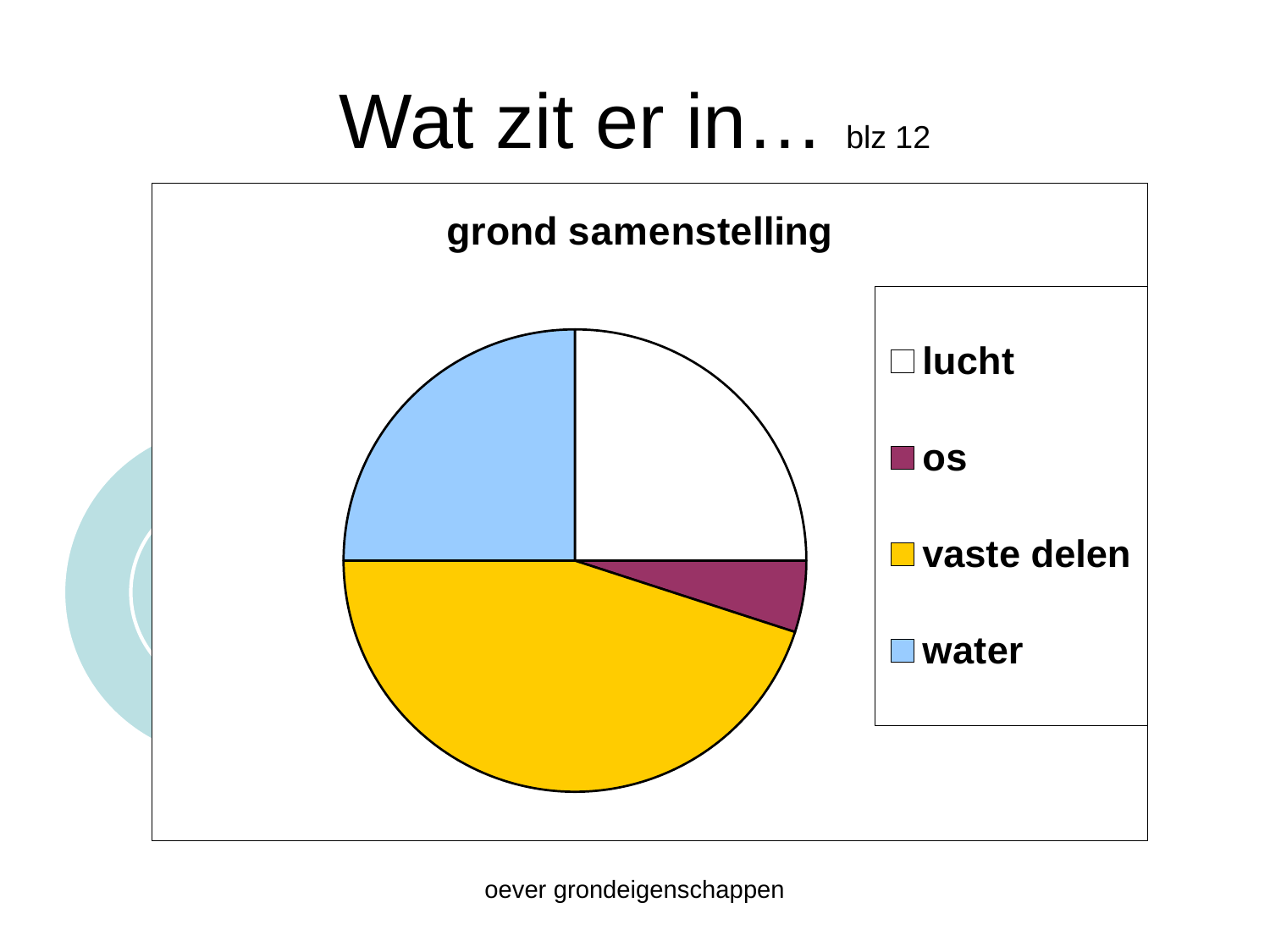
Which category has the largest slice of the pie? vaste delen Which slice is larger, vaste delen or lucht? vaste delen How many entries does the legend list? 4 Which category has the smallest slice of the pie? os What is the title of the chart? grond samenstelling What kind of chart is shown on the slide? pie chart How many slices does the pie chart have? 4 What colour is the slice for water? light blue Which slice is larger, water or os? water Which slice is larger, vaste delen or os? vaste delen